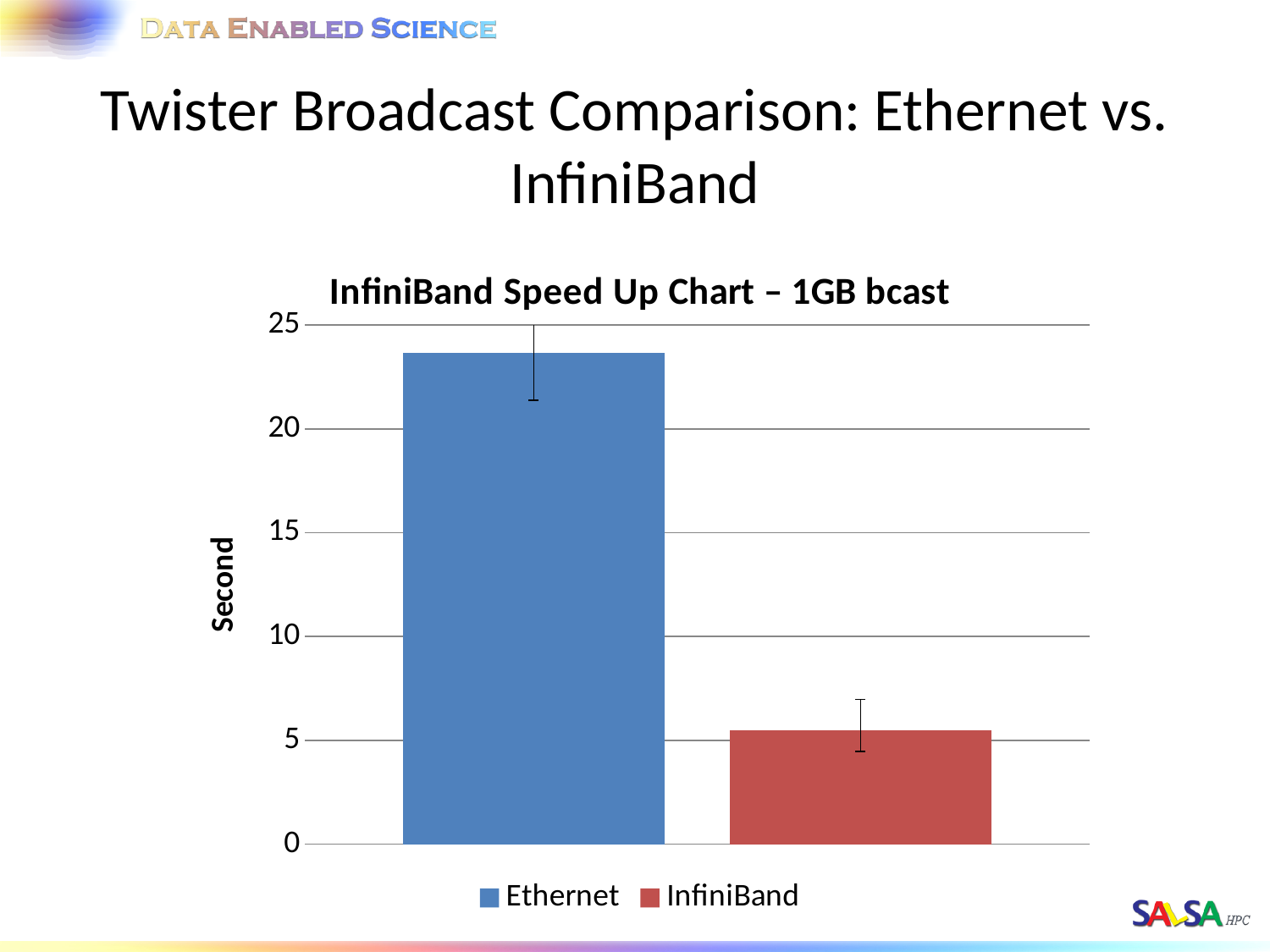
Is the value for InfiniBand greater or less than 10? less Which series has the highest value? Ethernet Is the value for Ethernet greater or less than 20? greater Is the value for InfiniBand greater or less than 5? greater Which series has the higher value, Ethernet or InfiniBand? Ethernet Which series has the lowest value? InfiniBand What kind of chart is shown on the slide? bar chart How many bars are plotted in the chart? 2 How many series does the legend list? 2 What is the label of the vertical axis? Second What is the title of the chart? InfiniBand Speed Up Chart – 1GB bcast